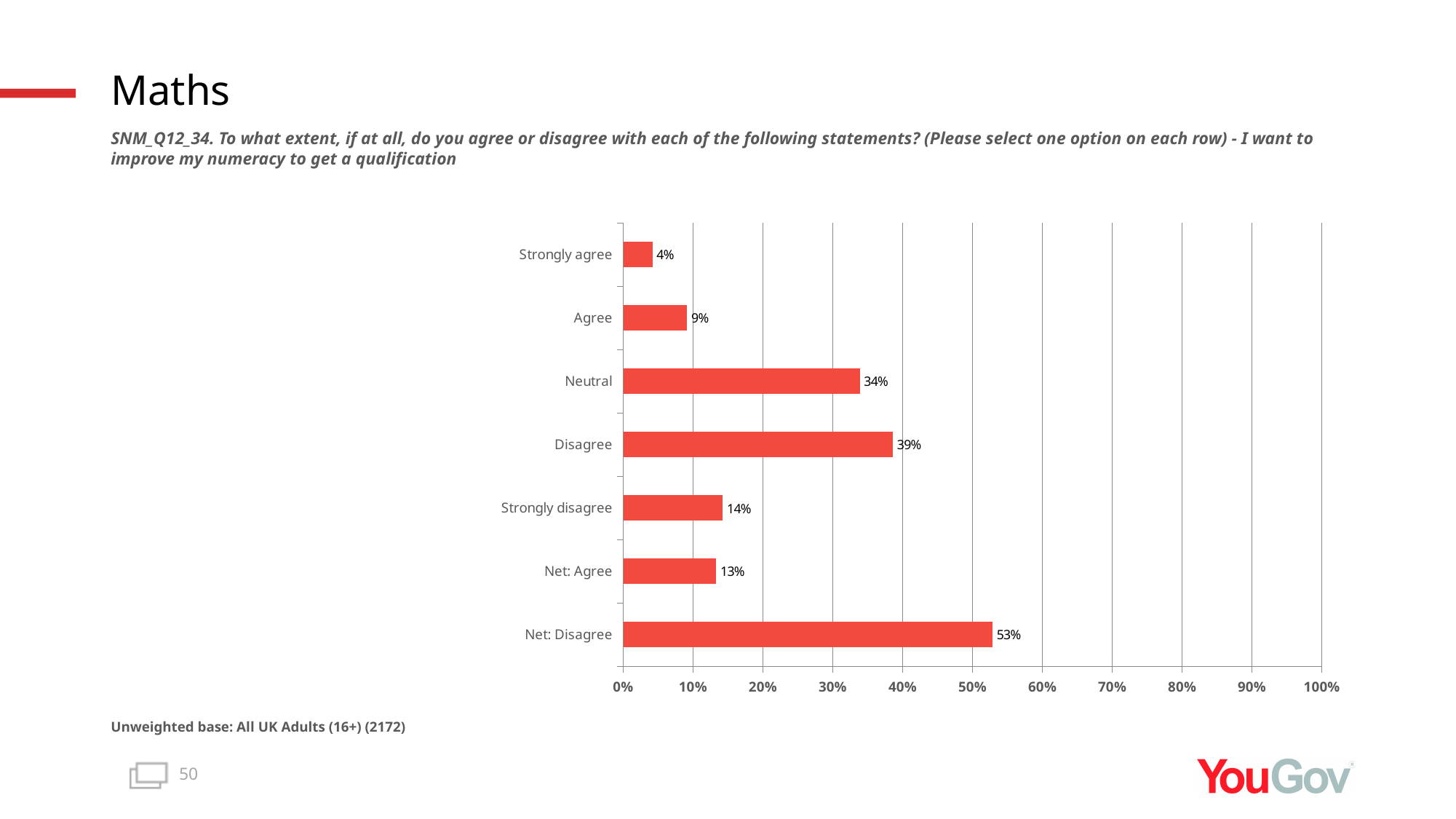
What percentage of respondents selected 'Neutral'? 34% Is the value for 'Net: Disagree' greater or less than 50%? greater What kind of chart is shown on the slide? Bar chart How many categories are shown on the chart? 7 Which category has the lowest value? Strongly agree What is the value shown for 'Net: Agree'? 13% Which is larger, 'Agree' or 'Strongly disagree'? Strongly disagree What is the value shown for 'Strongly disagree'? 14% What is the unweighted base stated below the chart? All UK Adults (16+) (2172) Which category has the highest value? Net: Disagree What is the difference between 'Net: Disagree' and 'Net: Agree'? 40% What is the difference between 'Disagree' and 'Neutral'? 5%